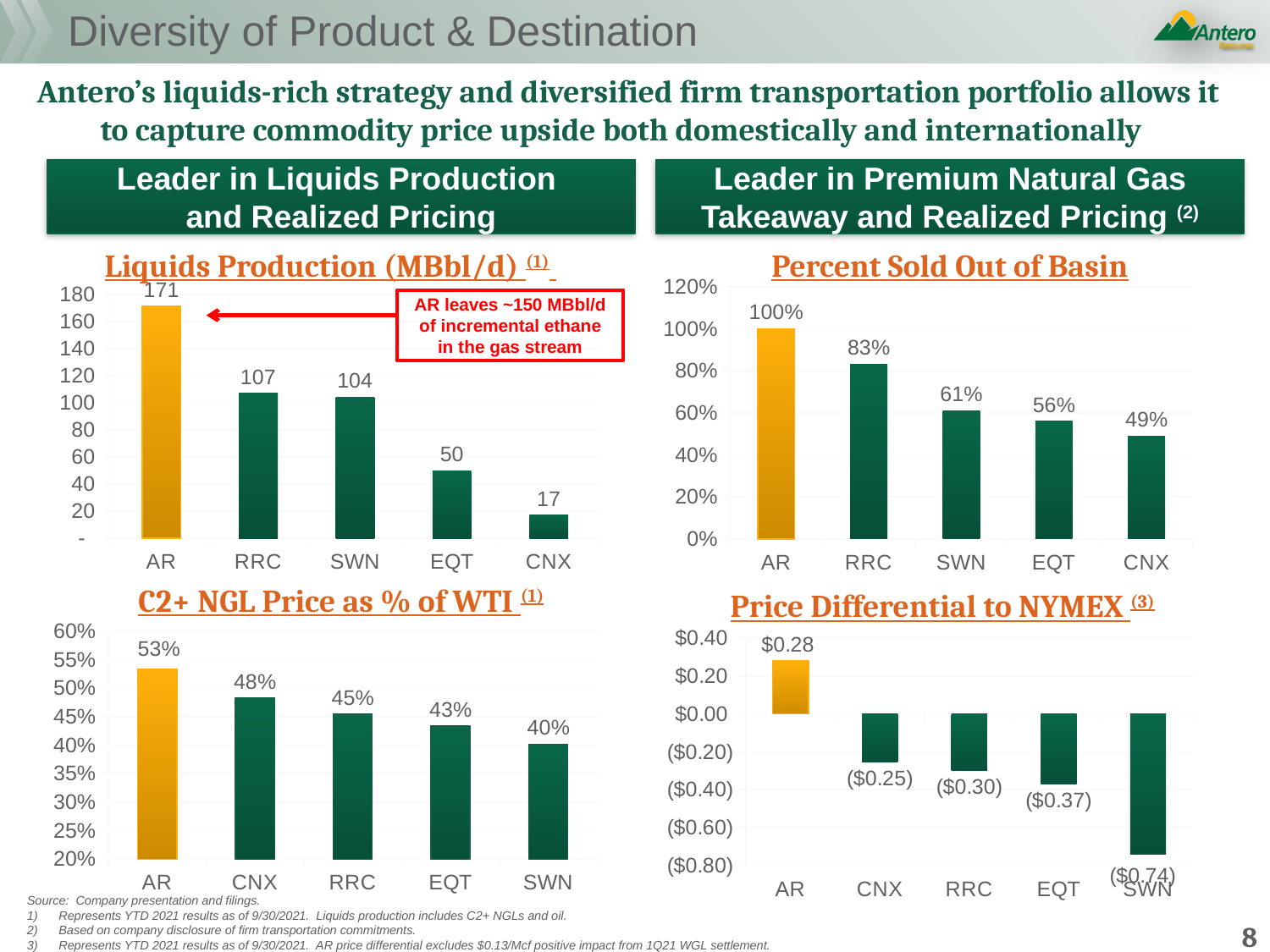
In the "C2+ NGL Price as % of WTI" chart, which company has the highest value? AR In the "Percent Sold Out of Basin" chart, what is the difference between RRC and CNX? 34% In the "C2+ NGL Price as % of WTI" chart, what is the value for EQT? 43% In the "Liquids Production (MBbl/d)" chart, what is the value for RRC? 107 In the "Price Differential to NYMEX" chart, what is the value for EQT? ($0.37) In the "C2+ NGL Price as % of WTI" chart, how many companies are shown? 5 What type of chart is the "Price Differential to NYMEX" chart? bar chart In the "Percent Sold Out of Basin" chart, what is the value for SWN? 61% In the "Percent Sold Out of Basin" chart, do the values rise or fall from left to right? fall In the "Price Differential to NYMEX" chart, which company has the lowest price differential? SWN In the "Liquids Production (MBbl/d)" chart, what is the difference between AR and SWN? 67 In the "Liquids Production (MBbl/d)" chart, which company has the lowest liquids production? CNX